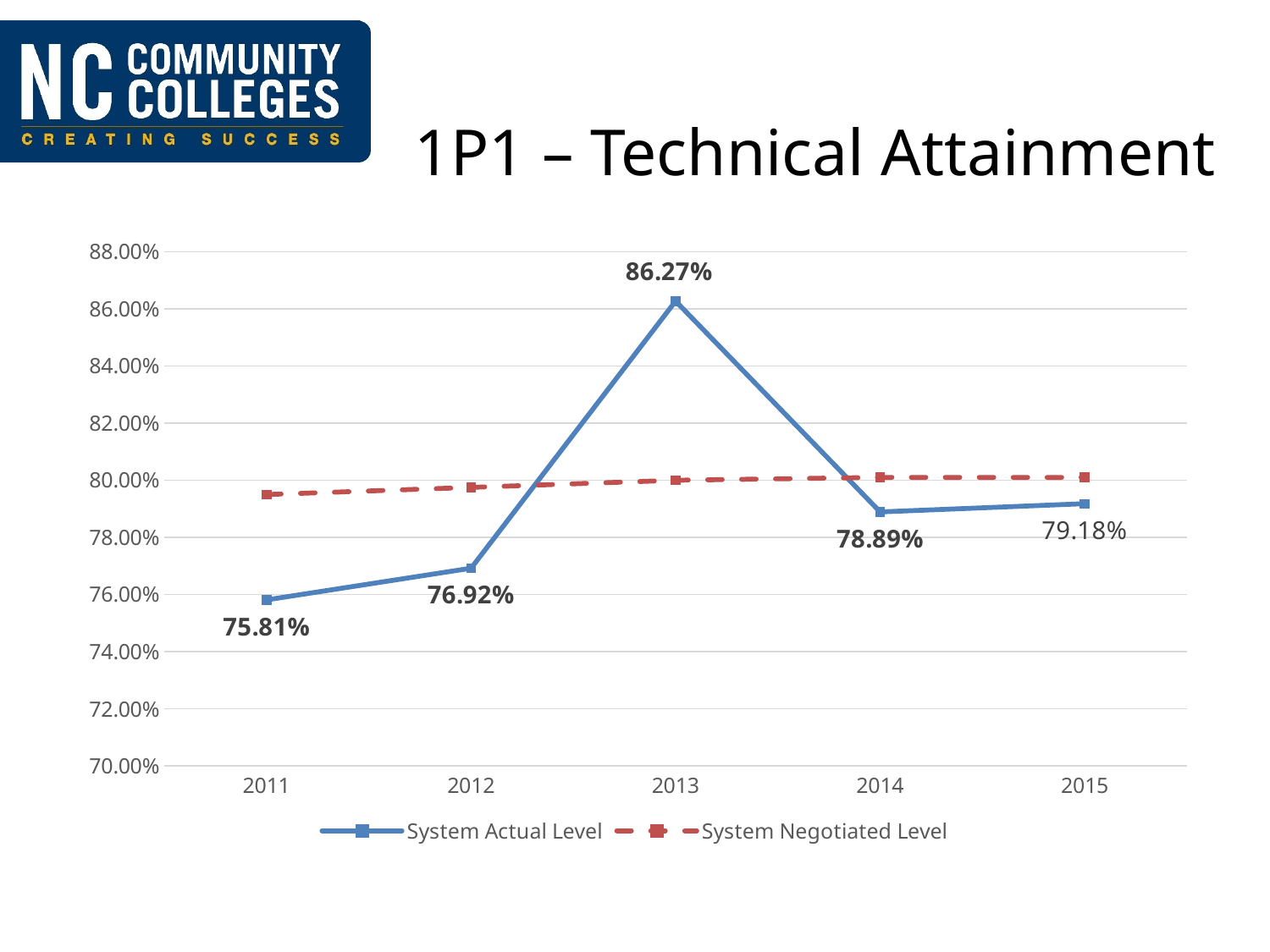
Is the System Negotiated Level for 2011 greater or less than 80.00%? less Which is larger, the System Actual Level in 2014 or in 2015? 2015 What kind of chart is shown on the slide? line chart What is the System Actual Level for 2013? 86.27% How many years are shown on the x axis? 5 How many series does the legend list? 2 In which year is the System Actual Level lowest? 2011 What is the System Actual Level for 2015? 79.18% Is the System Negotiated Level for 2015 greater or less than 78.00%? greater What is the difference between the System Actual Level in 2013 and in 2012? 9.35% In which year is the System Actual Level highest? 2013 What is the System Actual Level for 2011? 75.81%